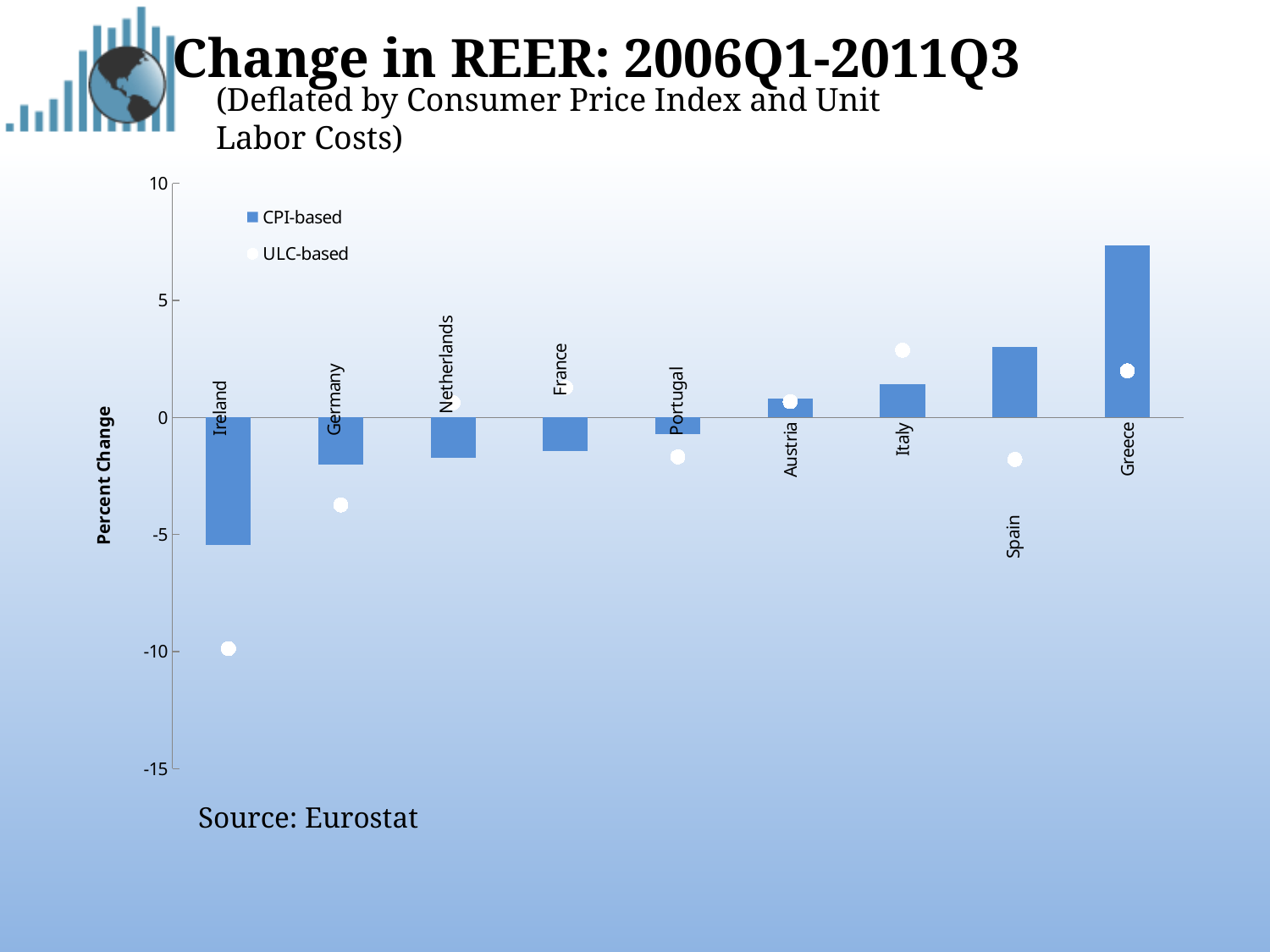
Is the CPI-based value for Germany greater or less than 0? less Which country has the lowest CPI-based value? Ireland What kind of chart is shown on the slide? bar chart How many countries are shown on the x axis of the chart? 9 What is the label on the vertical axis of the chart? Percent Change Do the CPI-based bars generally rise or fall from left to right across the countries? rise Which country has the highest CPI-based value? Greece How many series does the chart's legend list? 2 Is the ULC-based value for Ireland greater or less than -5? less Which is larger, the CPI-based value for Greece or the CPI-based value for Spain? Greece Is the CPI-based value for Greece greater or less than 5? greater Which country has the lowest ULC-based value? Ireland